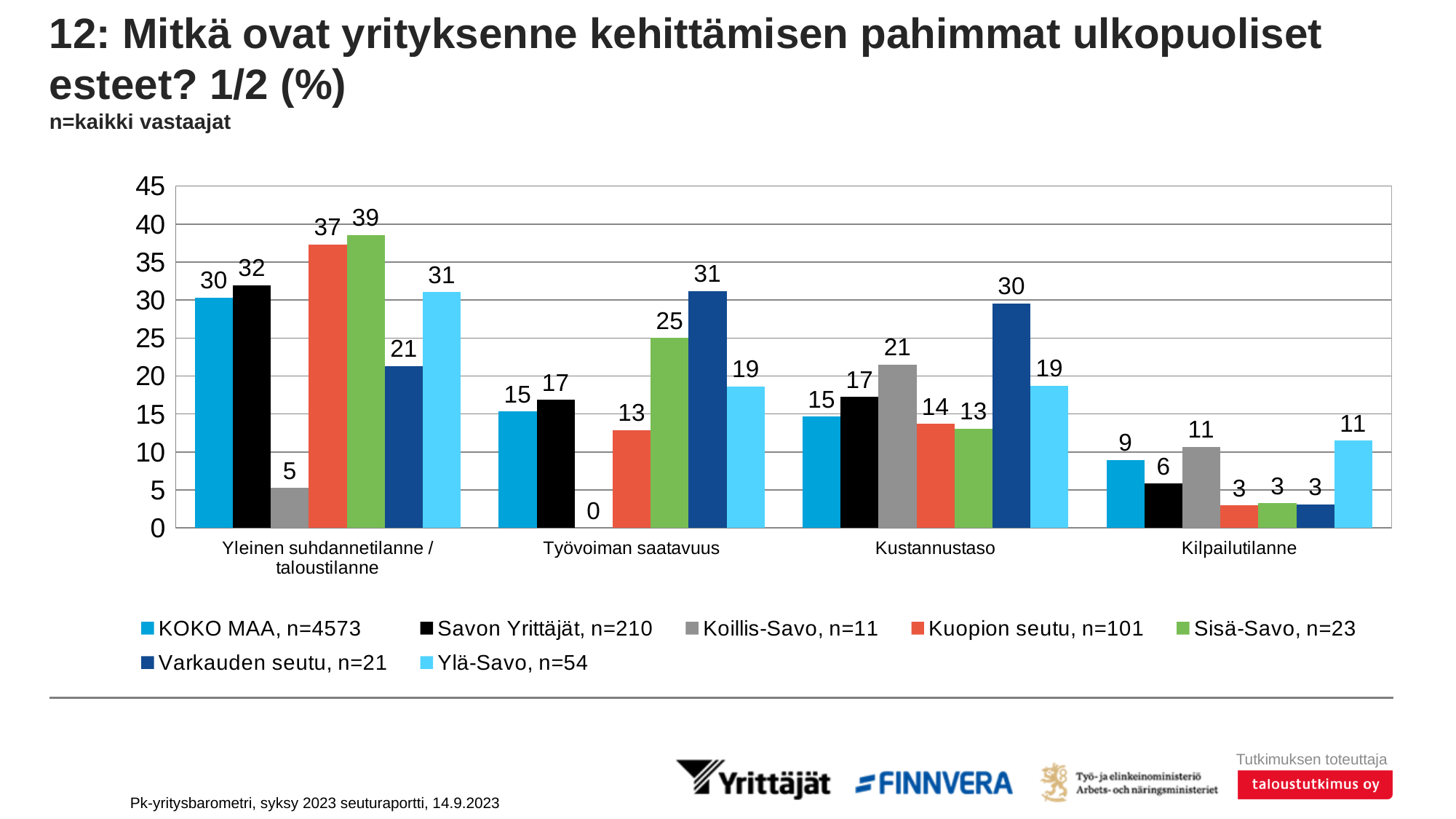
What is the difference between the Sisä-Savo, n=23 and Kuopion seutu, n=101 values in the Yleinen suhdannetilanne / taloustilanne category? 2 What kind of chart is shown on the slide? Bar chart How many categories are shown on the x axis? 4 What is the value for KOKO MAA, n=4573 in the Kilpailutilanne category? 9 Which series has the highest value in the Työvoiman saatavuus category? Varkauden seutu, n=21 Which series has the lowest value in the Yleinen suhdannetilanne / taloustilanne category? Koillis-Savo, n=11 What is the value for Sisä-Savo, n=23 in the Yleinen suhdannetilanne / taloustilanne category? 39 What is the value for Koillis-Savo, n=11 in the Työvoiman saatavuus category? 0 In the Kustannustaso category, which is larger: Koillis-Savo, n=11 or Kuopion seutu, n=101? Koillis-Savo, n=11 What is the value for Ylä-Savo, n=54 in the Kilpailutilanne category? 11 What is the value for Varkauden seutu, n=21 in the Kustannustaso category? 30 How many series does the legend list? 7